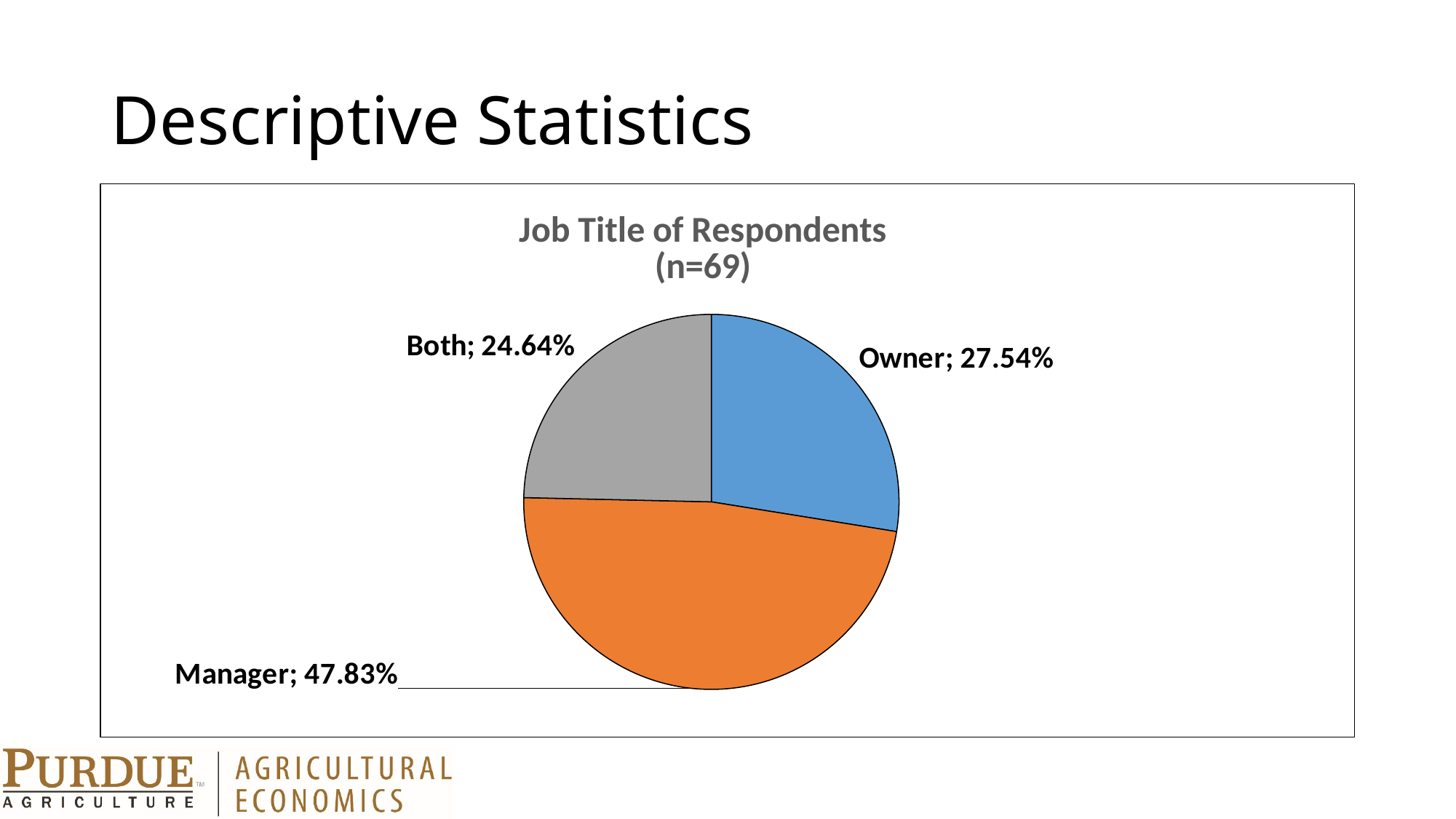
How many job title categories are shown in the pie chart? 3 What percentage of respondents are Both? 24.64% What percentage of respondents are Owners? 27.54% What type of chart is shown on the slide? pie chart Which job title has the smallest share of respondents? Both What is the difference in percentage points between the Manager and Owner shares? 20.29 What colour is the Manager slice of the pie chart? orange Which share is larger, Owner or Both? Owner What is the difference in percentage points between the Owner and Both shares? 2.90 Which job title has the largest share of respondents? Manager What is the title of the chart? Job Title of Respondents (n=69) What percentage of respondents are Managers? 47.83%